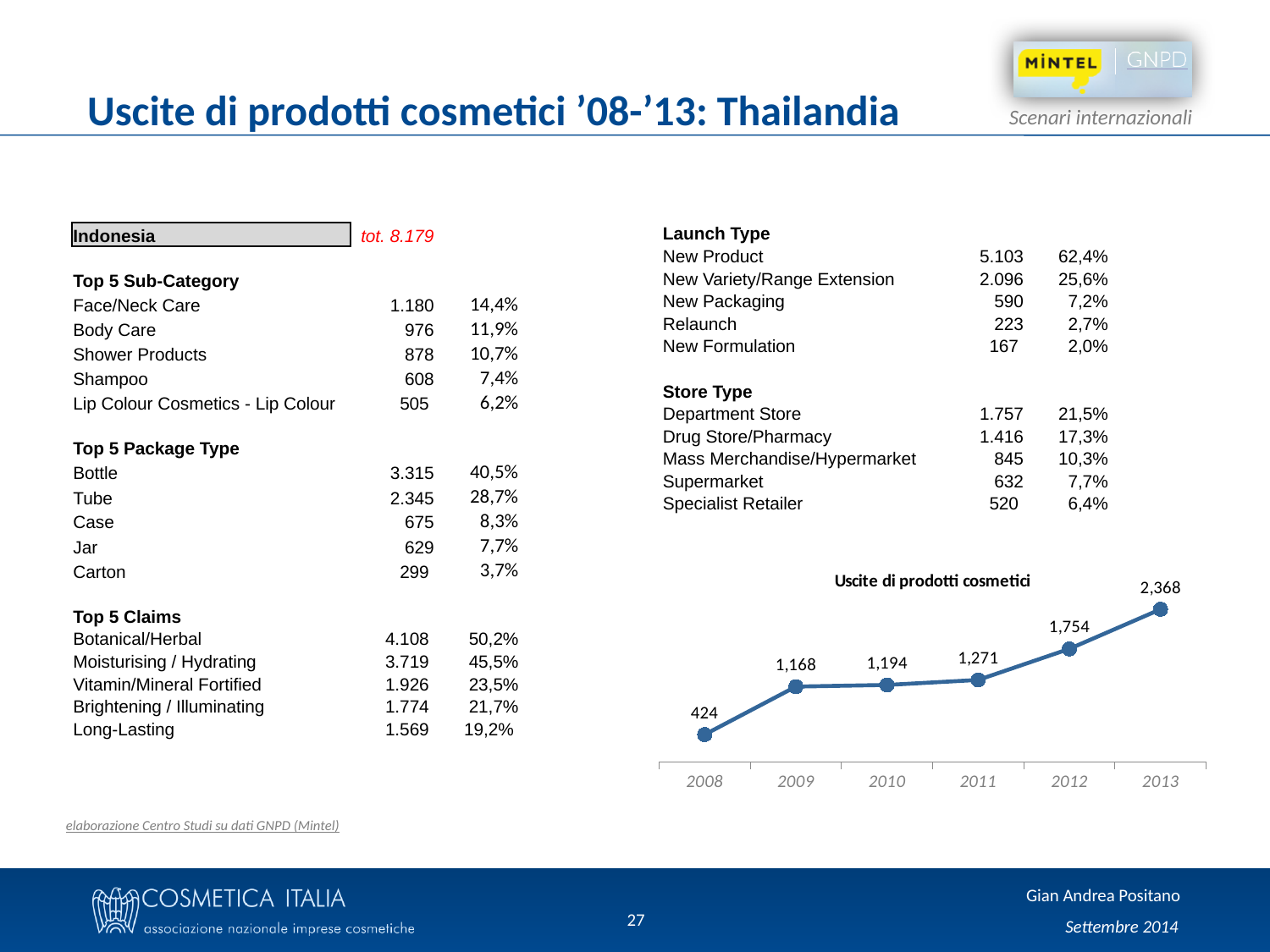
What is the difference between the values for 2013 and 2012 in the chart? 614 What is the difference between the values for 2009 and 2008 in the chart? 744 Which year has the highest value in the chart? 2013 Which year has the lowest value in the chart? 2008 Which is larger in the chart, the value for 2012 or the value for 2010? 2012 Do the values in the chart rise or fall from 2008 to 2013? rise What is the value for 2011 in the chart? 1,271 What type of chart is shown on the slide? line chart What is the value for 2008 in the chart? 424 How many years are plotted in the chart? 6 What is the value for 2013 in the chart? 2,368 What is the title of the chart? Uscite di prodotti cosmetici